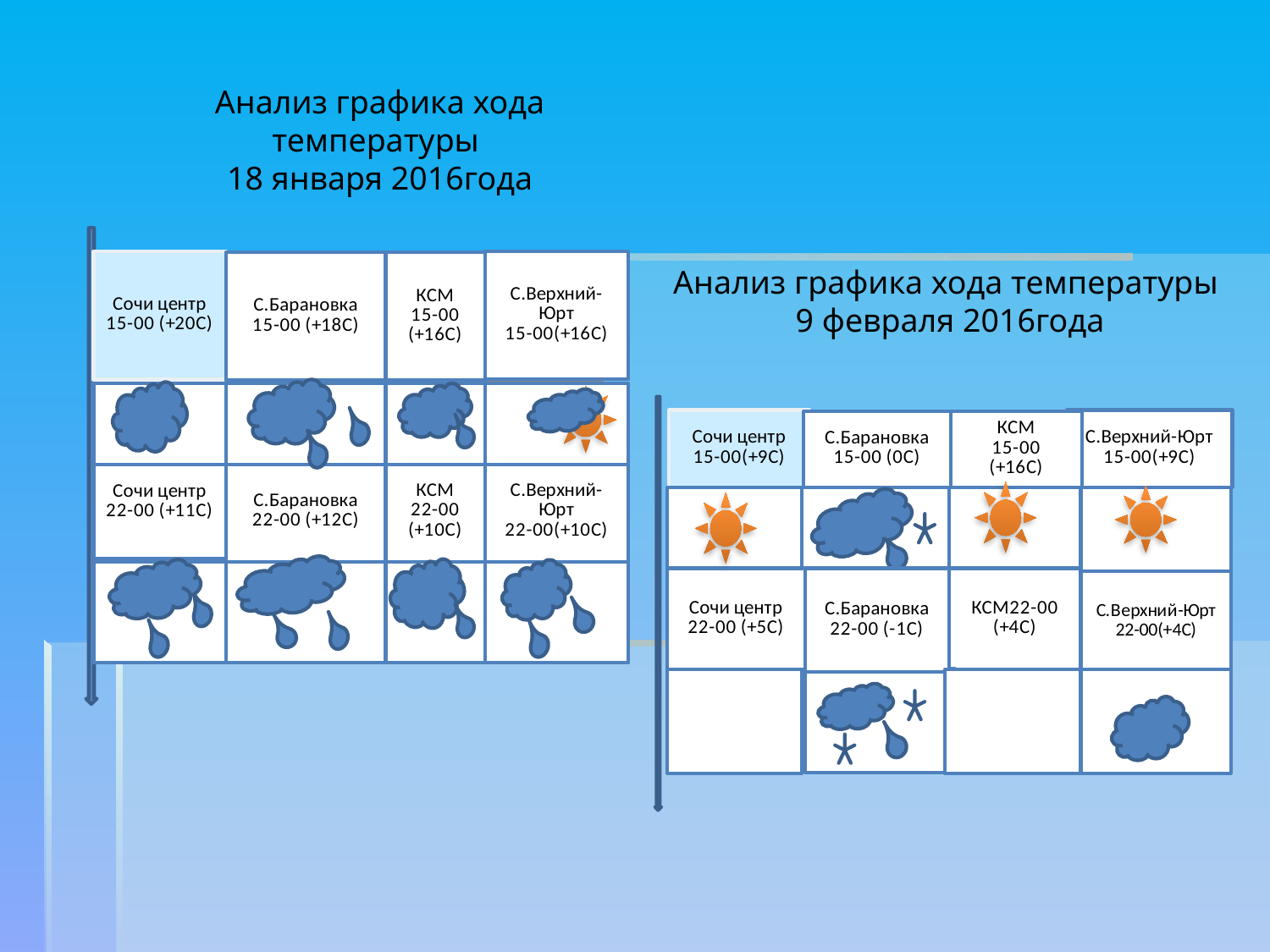
In the table for 9 February 2016, what temperature is given for С.Барановка at 22-00? -1C In the table for 9 February 2016, what is the difference between the 15-00 temperatures of КСМ and Сочи центр? 7C In the table for 18 January 2016, which location has the highest temperature at 15-00? Сочи центр In the table for 18 January 2016, what is the difference between the 15-00 and 22-00 temperatures for Сочи центр? 9C In the table for 9 February 2016, what temperature is given for КСМ at 15-00? +16C In the table for 18 January 2016, what temperature is given for С.Барановка at 22-00? +12C In the table for 9 February 2016, which is higher at 22-00: Сочи центр or С.Верхний-Юрт? Сочи центр In the table for 18 January 2016, what temperature is given for Сочи центр at 15-00? +20C In the table for 9 February 2016, which location has the lowest temperature at 15-00? С.Барановка In the table for 18 January 2016, which is higher at 22-00: С.Барановка or КСМ? С.Барановка How many locations are listed in the table for 18 January 2016? 4 In the table for 9 February 2016, which weather icon is shown for Сочи центр at 15-00? Sun